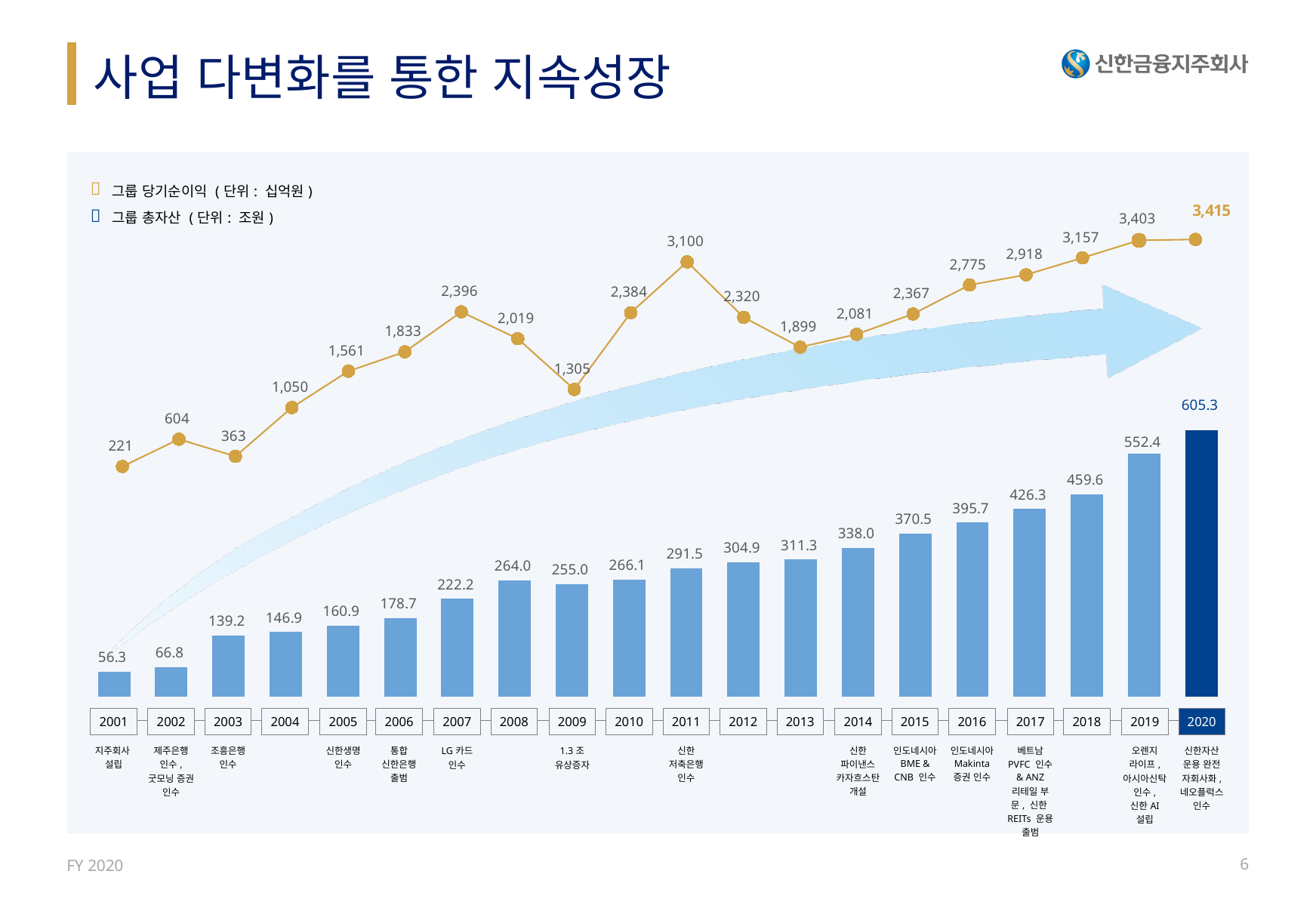
What is the difference in 그룹 총자산 between 2020 and 2019? 52.9 How many years are shown on the x axis of the chart? 20 How many series does the legend list? 2 What unit is given in the legend for 그룹 총자산? 조원 What is the difference in 그룹 당기순이익 between 2011 and 2012? 780 Which year has the lowest 그룹 총자산? 2001 What is the 그룹 당기순이익 value for 2011? 3,100 Do the 그룹 총자산 bars generally rise or fall from 2001 to 2020? rise Which year has the larger 그룹 당기순이익, 2008 or 2009? 2008 What is the 그룹 총자산 value for 2020? 605.3 Which year has the highest 그룹 당기순이익? 2020 What is the 그룹 총자산 value for 2007? 222.2